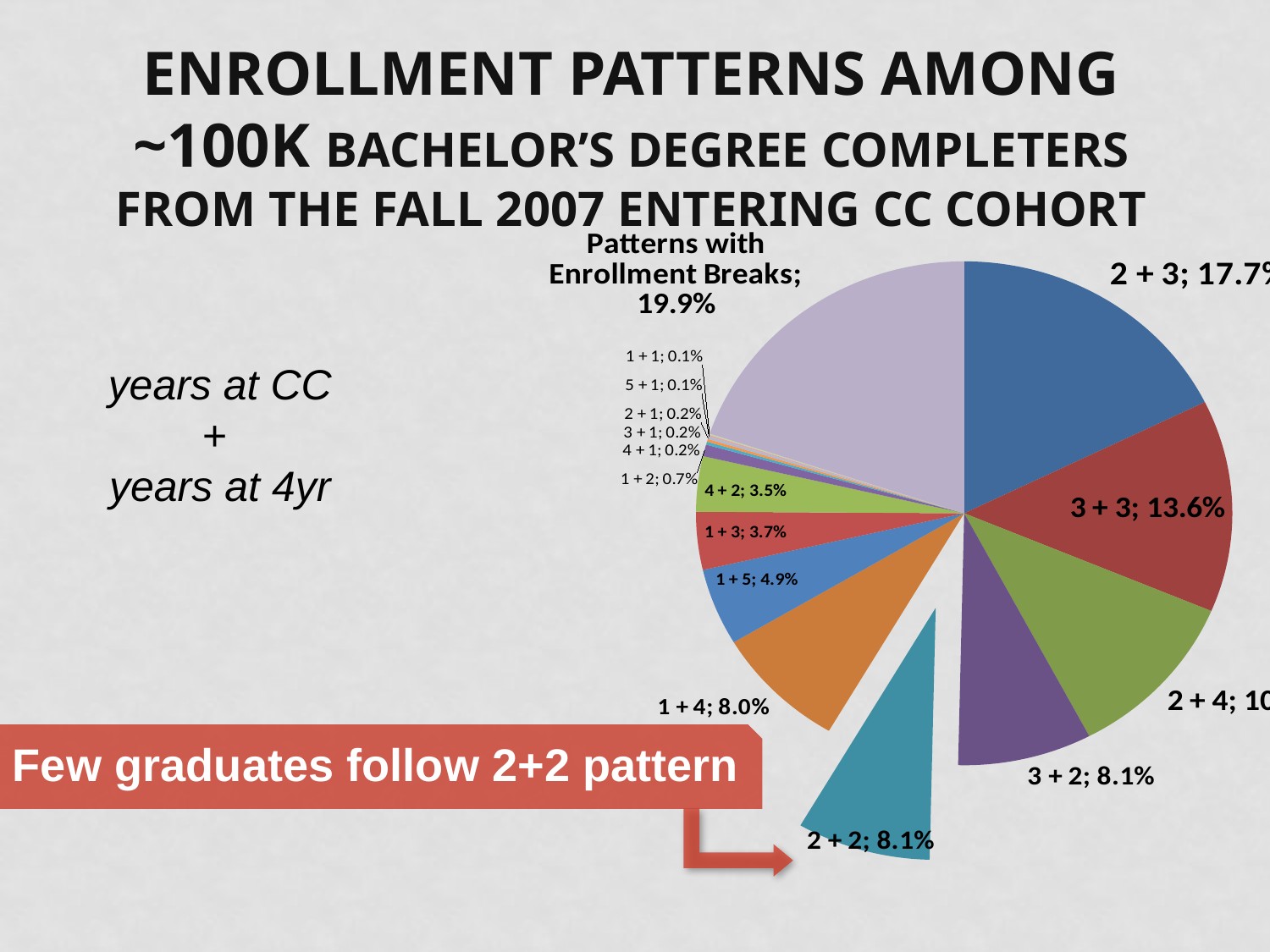
What percentage is shown for Patterns with Enrollment Breaks? 19.9% Which is larger, the 1 + 5 slice or the 1 + 3 slice? 1 + 5 What share of graduates followed the 3 + 3 pattern? 13.6% What share of graduates followed the 1 + 4 pattern? 8.0% What share of graduates followed the 2 + 2 pattern? 8.1% Which slice of the pie is the largest? Patterns with Enrollment Breaks What is the difference in percentage points between the 2 + 3 slice and the 3 + 3 slice? 4.1 What share of graduates followed the 2 + 3 pattern? 17.7% Which slice is pulled out (exploded) from the pie? 2 + 2 How many slices does the pie chart have? 16 What share of graduates followed the 1 + 2 pattern? 0.7% What kind of chart is shown on the slide? pie chart